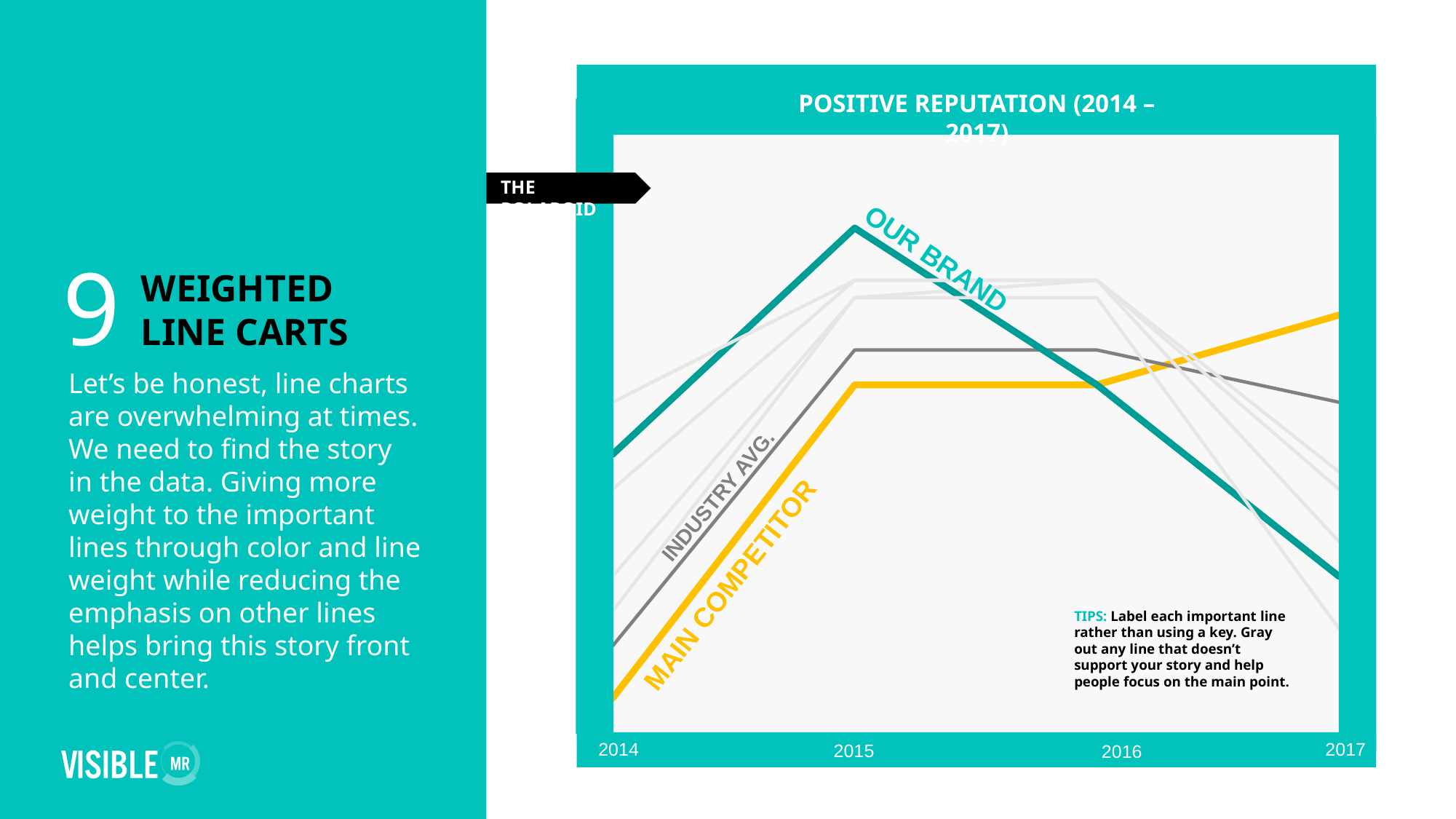
Does the OUR BRAND line rise or fall between 2014 and 2015? Rise Which three lines are labeled by name on the chart? OUR BRAND, MAIN COMPETITOR, INDUSTRY AVG. In 2017, which line is higher: OUR BRAND or MAIN COMPETITOR? MAIN COMPETITOR In 2017, which line is higher: INDUSTRY AVG. or OUR BRAND? INDUSTRY AVG. What is the title of the chart? POSITIVE REPUTATION (2014 – 2017) What kind of chart is shown on the slide? Line chart How many years are shown on the x axis of the chart? 4 Does the OUR BRAND line rise or fall between 2015 and 2017? Fall In which year does the OUR BRAND line reach its highest point? 2015 In which year does the MAIN COMPETITOR line reach its lowest point? 2014 Does the MAIN COMPETITOR line rise or fall between 2016 and 2017? Rise In 2015, which line is higher: OUR BRAND or MAIN COMPETITOR? OUR BRAND